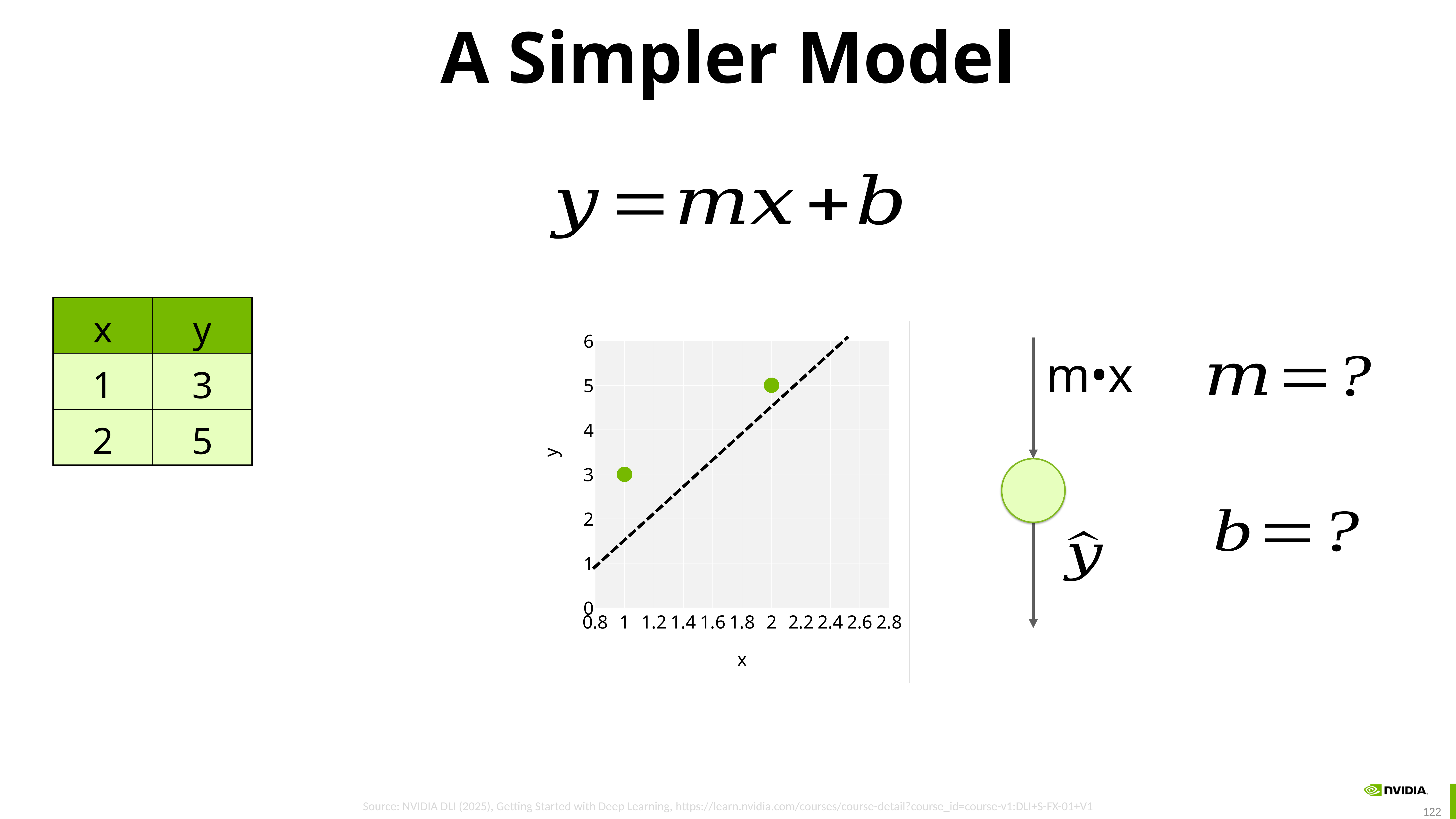
Which plotted point has the higher y value, the one at x = 1 or the one at x = 2? x = 2 What kind of chart is shown on the slide? scatter chart What is the y value of the plotted point at x = 1? 3 What is the highest y value among the plotted points? 5 What is the difference in y between the point at x = 2 and the point at x = 1? 2 Is the y value of the point at x = 1 greater or less than 4? less What is the lowest y value among the plotted points? 3 Is the y value of the point at x = 2 greater or less than 4? greater What is the y value of the plotted point at x = 2? 5 Do the plotted y values rise or fall as x increases? rise What label is shown on the horizontal axis of the chart? x How many data points are plotted on the chart? 2